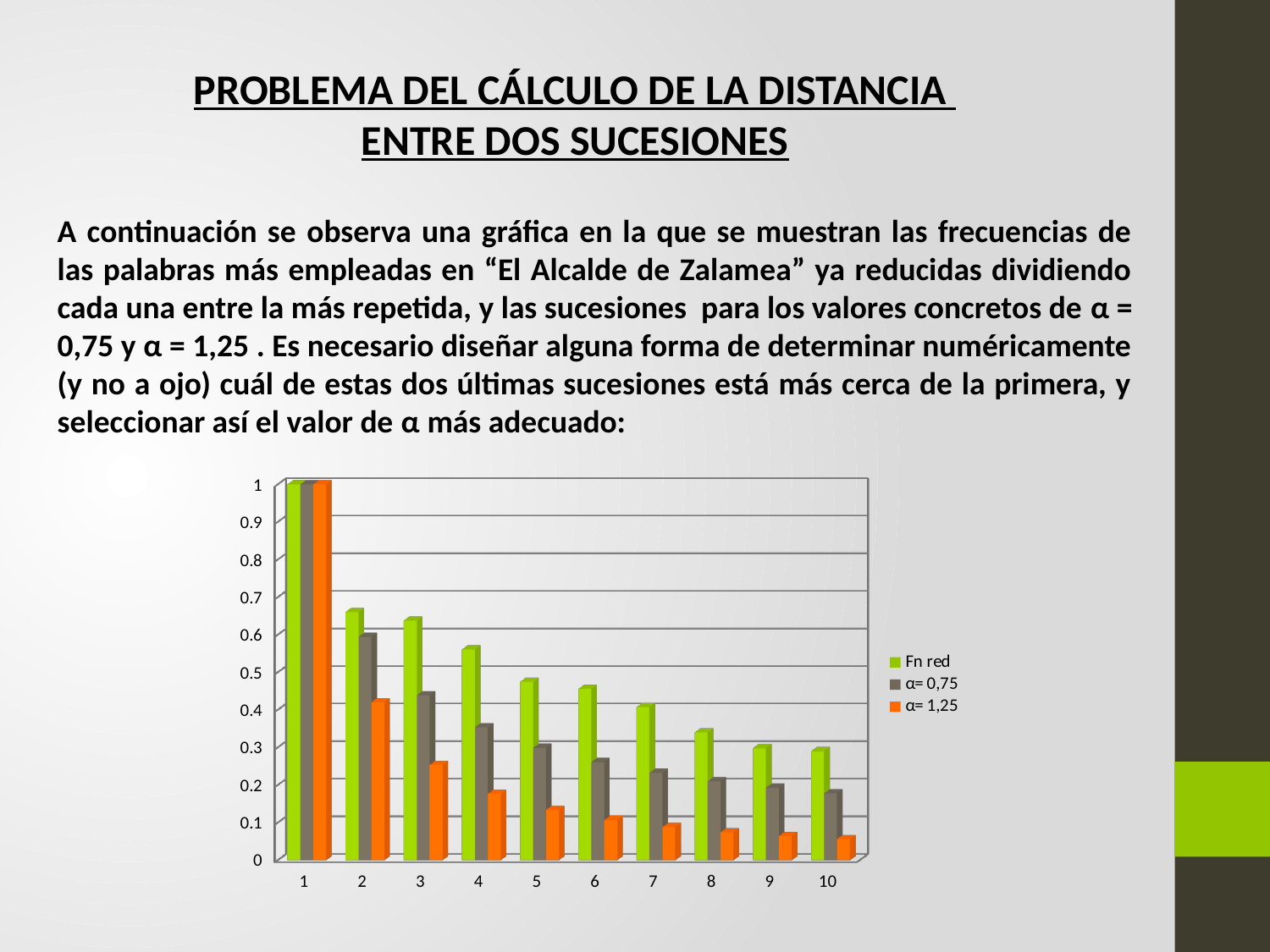
How many series does the chart legend list? 3 Is the value of α= 1,25 at category 10 greater or less than 0.1? less What are the three series named in the chart legend? Fn red, α= 0,75, α= 1,25 How many categories are shown along the x axis of the chart? 10 Do the values of the α= 1,25 series rise or fall as the category number increases from 1 to 10? fall Is the value of α= 1,25 at category 2 greater or less than 0.5? less What kind of chart is shown on the slide? bar chart Is the value of Fn red at category 2 greater or less than 0.6? greater What is the value of the Fn red series at category 1? 1 At category 3, which series has the larger value, Fn red or α= 1,25? Fn red For the α= 1,25 series, which category has the lowest value? 10